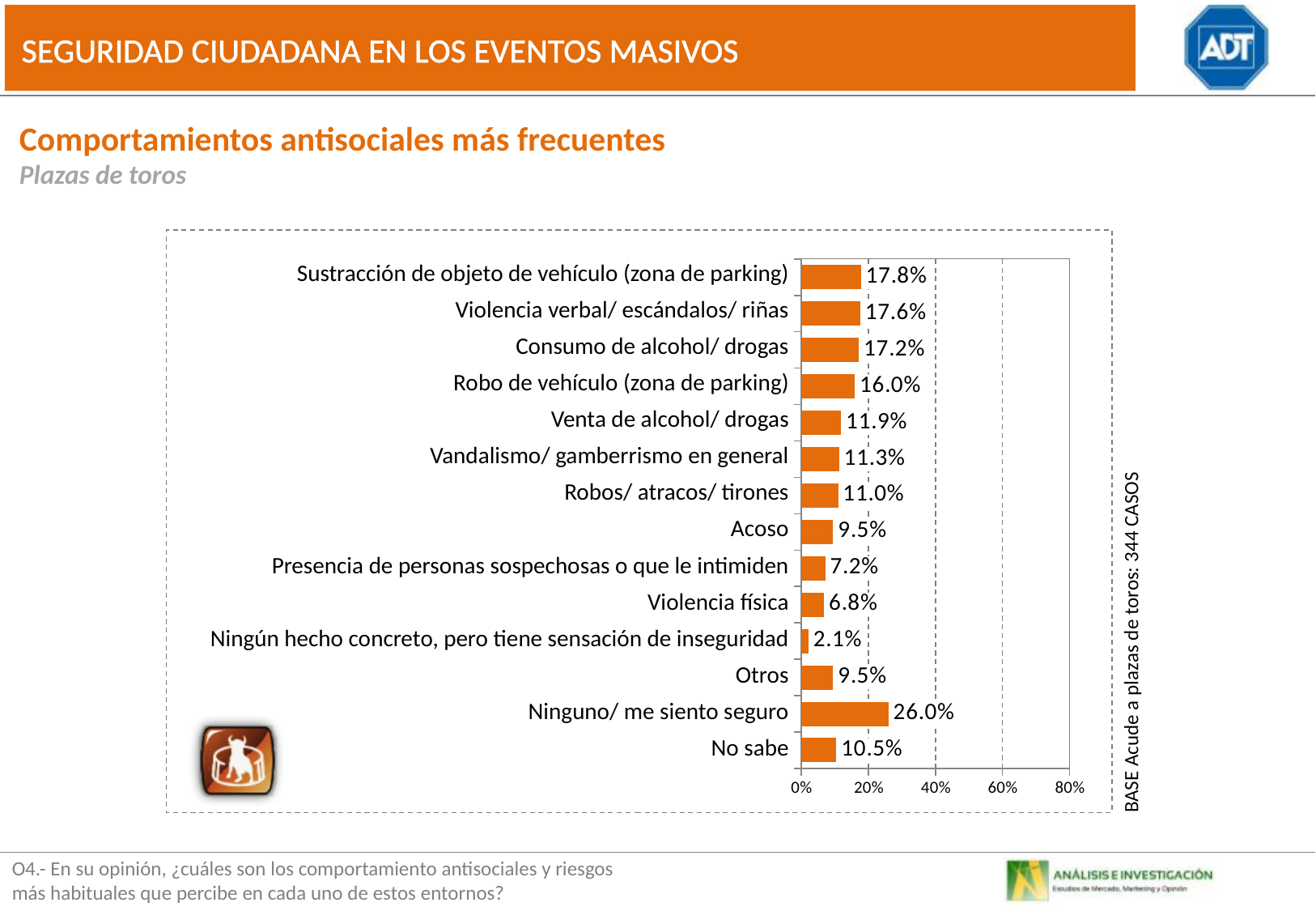
What is the value for "Sustracción de objeto de vehículo (zona de parking)"? 17.8% What is the base (number of cases) stated for the chart? 344 CASOS Which category has the highest value? Ninguno/ me siento seguro What is the value for "No sabe"? 10.5% Which category has the lowest value? Ningún hecho concreto, pero tiene sensación de inseguridad What is the value for "Violencia física"? 6.8% Is the value for "Robo de vehículo (zona de parking)" greater or less than 20%? less Which is larger, "Venta de alcohol/ drogas" or "Acoso"? Venta de alcohol/ drogas What kind of chart is shown on the slide? bar chart What is the value for "Ninguno/ me siento seguro"? 26.0% How many categories are shown in the chart? 14 What is the difference between "Ninguno/ me siento seguro" and "Sustracción de objeto de vehículo (zona de parking)"? 8.2%